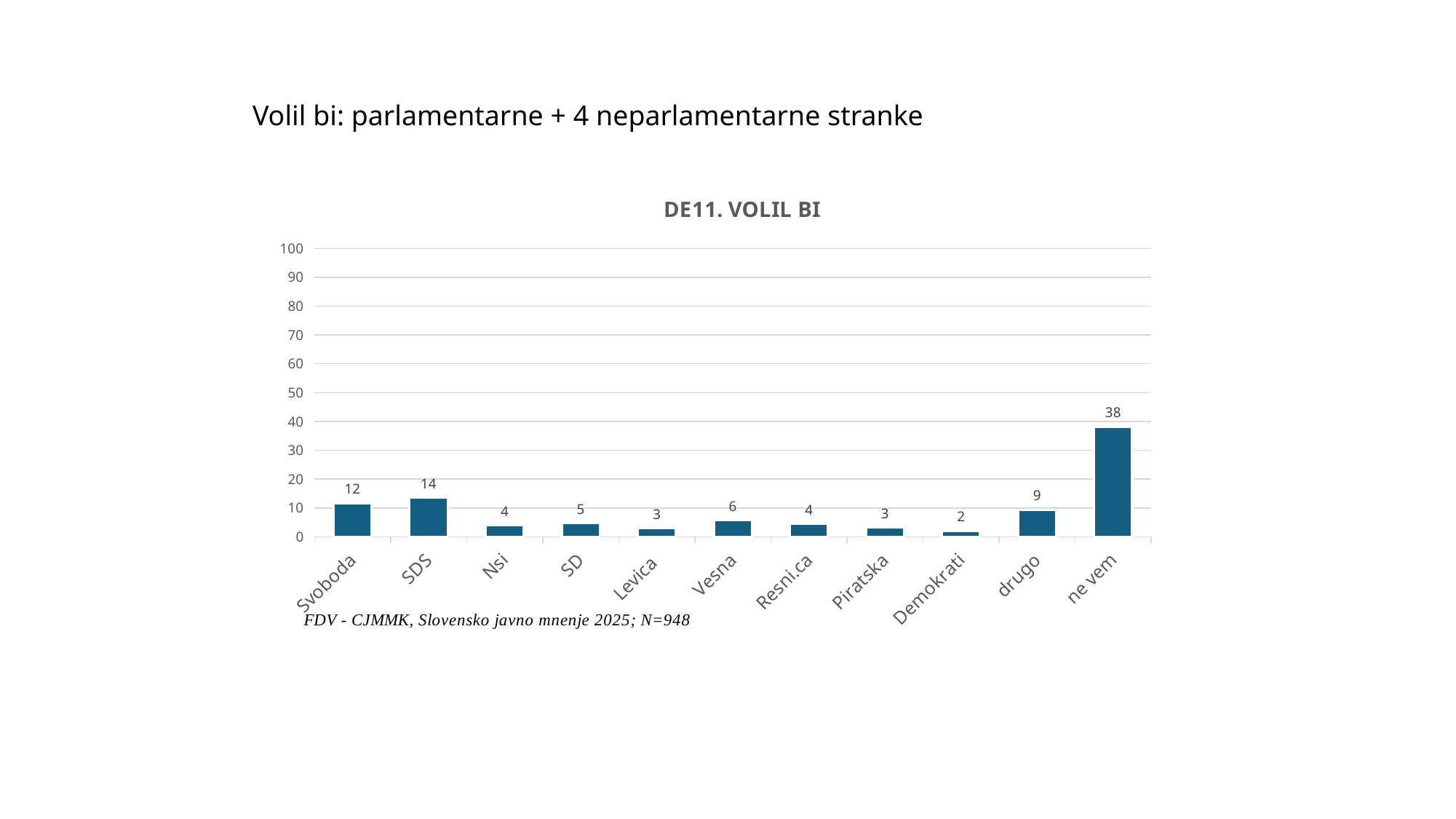
What is the difference between the values for SDS and Svoboda? 2 Which category has the highest value? ne vem Which category has the lowest value? Demokrati What is the title of the chart? DE11. VOLIL BI How many categories are shown on the x axis? 11 What is the difference between the values for ne vem and drugo? 29 What is the value for ne vem? 38 What is the value for Vesna? 6 What is the value for drugo? 9 Which is larger, the value for Svoboda or the value for SDS? SDS What kind of chart is this? bar chart What is the value for SDS? 14